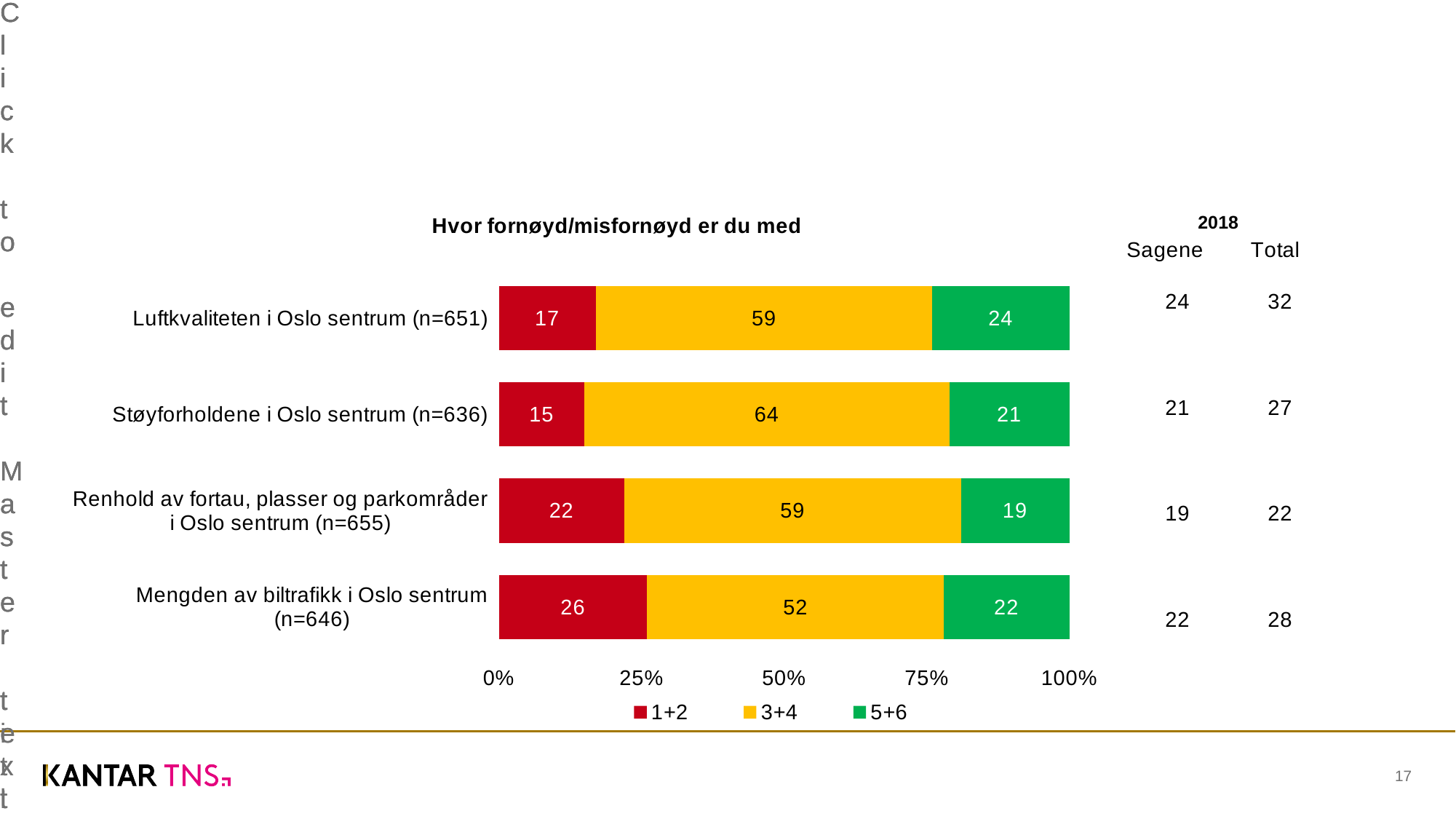
What is the difference between the 3+4 values for Støyforholdene i Oslo sentrum (n=636) and Mengden av biltrafikk i Oslo sentrum (n=646)? 12 How many series does the legend list? 3 What is the title of the chart? Hvor fornøyd/misfornøyd er du med What is the total of the stacked bar for Luftkvaliteten i Oslo sentrum (n=651)? 100 How many categories are shown in the chart? 4 What kind of chart is shown on the slide? Stacked bar chart Which category has the highest value for the 1+2 series? Mengden av biltrafikk i Oslo sentrum (n=646) What is the value of the 5+6 series for Mengden av biltrafikk i Oslo sentrum (n=646)? 22 Which category has the lowest value for the 5+6 series? Renhold av fortau, plasser og parkområder i Oslo sentrum (n=655) What is the value of the 1+2 series for Luftkvaliteten i Oslo sentrum (n=651)? 17 Which is larger: the 1+2 value for Renhold av fortau, plasser og parkområder i Oslo sentrum (n=655) or the 1+2 value for Støyforholdene i Oslo sentrum (n=636)? Renhold av fortau, plasser og parkområder i Oslo sentrum (n=655) What is the value of the 3+4 series for Støyforholdene i Oslo sentrum (n=636)? 64